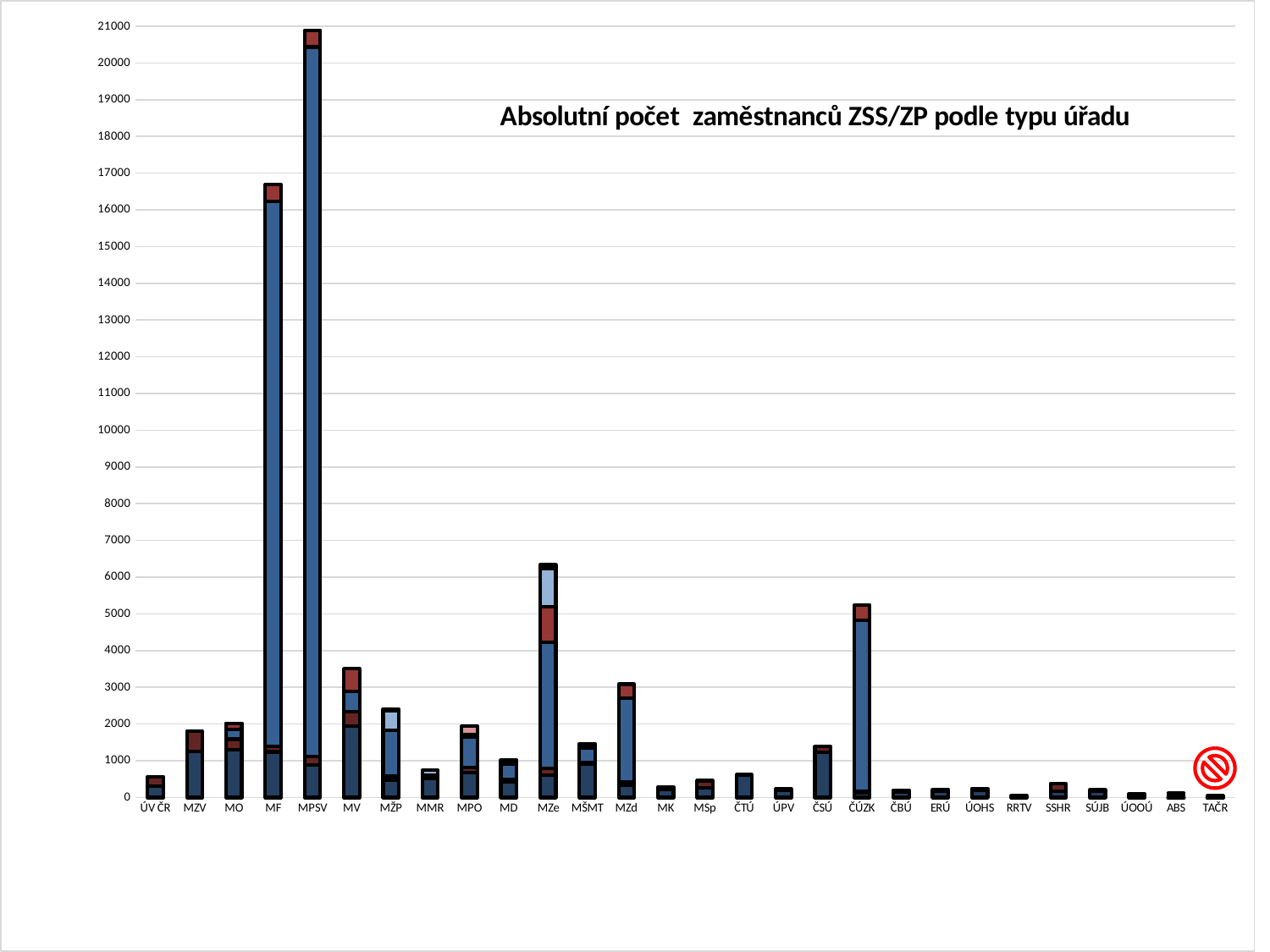
Is the total value for MŽP greater or less than 3000? less Is the total value for MPSV greater or less than 20000? greater Which has the larger total bar, MV or MŽP? MV How many categories (úřady) are shown on the x axis? 28 What is the title of the chart? Absolutní počet zaměstnanců ZSS/ZP podle typu úřadu Which has the larger total bar, MZe or ČÚZK? MZe Is the total value for MF greater or less than 16000? greater Which category has the highest total bar? MPSV What kind of chart is shown on the slide? Stacked bar chart